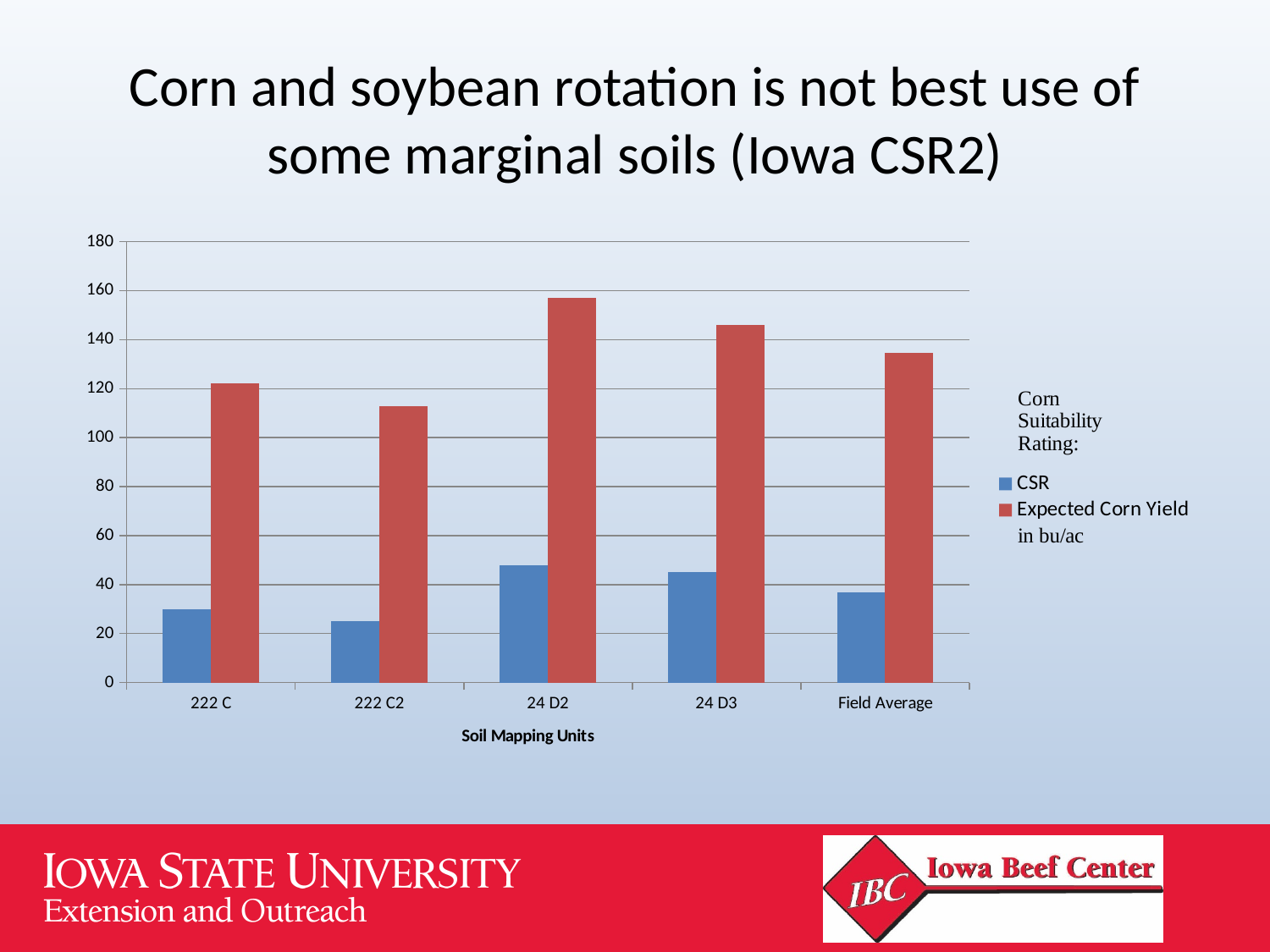
Is the Expected Corn Yield for 24 D2 greater or less than 140? greater What is the title of the x axis? Soil Mapping Units Is the CSR for 222 C greater or less than 40? less Which has the larger Expected Corn Yield, 24 D2 or 24 D3? 24 D2 Is the CSR for 24 D2 greater or less than 40? greater Which soil mapping unit has the highest Expected Corn Yield? 24 D2 Which soil mapping unit has the lowest Expected Corn Yield? 222 C2 How many soil mapping unit categories are shown on the x axis? 5 What kind of chart is shown on the slide? bar chart Which soil mapping unit has the lowest CSR? 222 C2 How many series does the legend list? 2